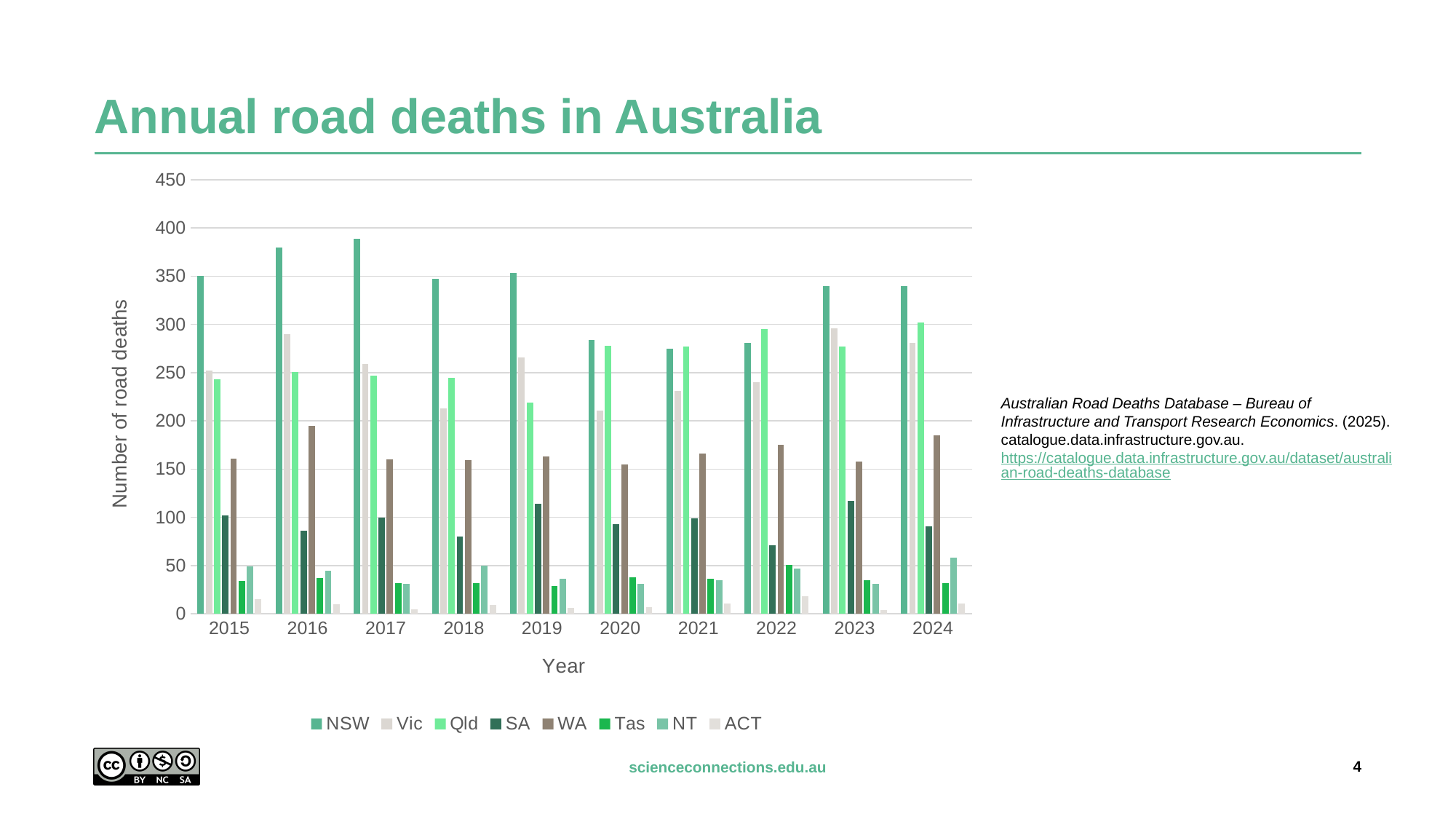
Is the value for NSW in 2017 greater or less than 350? greater In which year was the NSW value highest? 2017 Is the value for Vic in 2018 greater or less than 250? less Which state or territory has the lowest value in 2024? ACT Is the value for SA in 2023 greater or less than 100? greater Do the NSW values rise or fall from 2017 to 2021? Fall How many years are shown on the x axis? 10 In 2022, which is larger, the value for Qld or the value for Vic? Qld What kind of chart is shown on the slide? Bar chart How many series does the legend list? 8 What is the title of the y axis? Number of road deaths